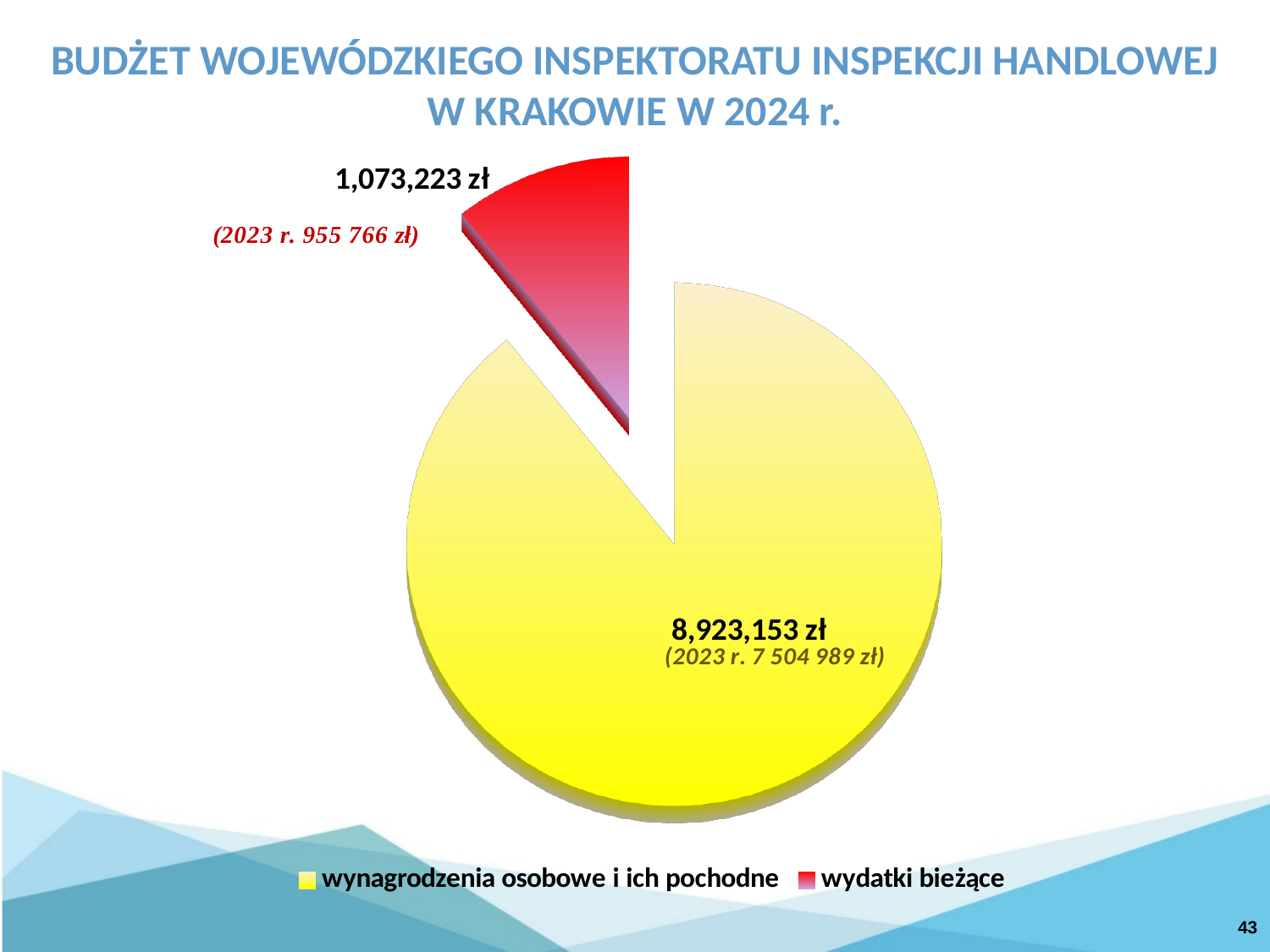
How many slices does the pie chart have? 2 Which category has the largest slice of the pie? wynagrodzenia osobowe i ich pochodne Which is larger in 2024: "wynagrodzenia osobowe i ich pochodne" or "wydatki bieżące"? wynagrodzenia osobowe i ich pochodne What type of chart is shown on the slide? pie chart What colour is the slice for "wydatki bieżące"? red What is the total of the two 2024 values shown in the pie chart? 9,996,376 zł What is the 2024 value for "wynagrodzenia osobowe i ich pochodne"? 8,923,153 zł What is the 2024 value for "wydatki bieżące"? 1,073,223 zł What was the 2023 value shown for "wynagrodzenia osobowe i ich pochodne"? 7 504 989 zł What is the difference between the 2024 values for "wynagrodzenia osobowe i ich pochodne" and "wydatki bieżące"? 7,849,930 zł What was the 2023 value shown for "wydatki bieżące"? 955 766 zł Which category has the smallest slice of the pie? wydatki bieżące